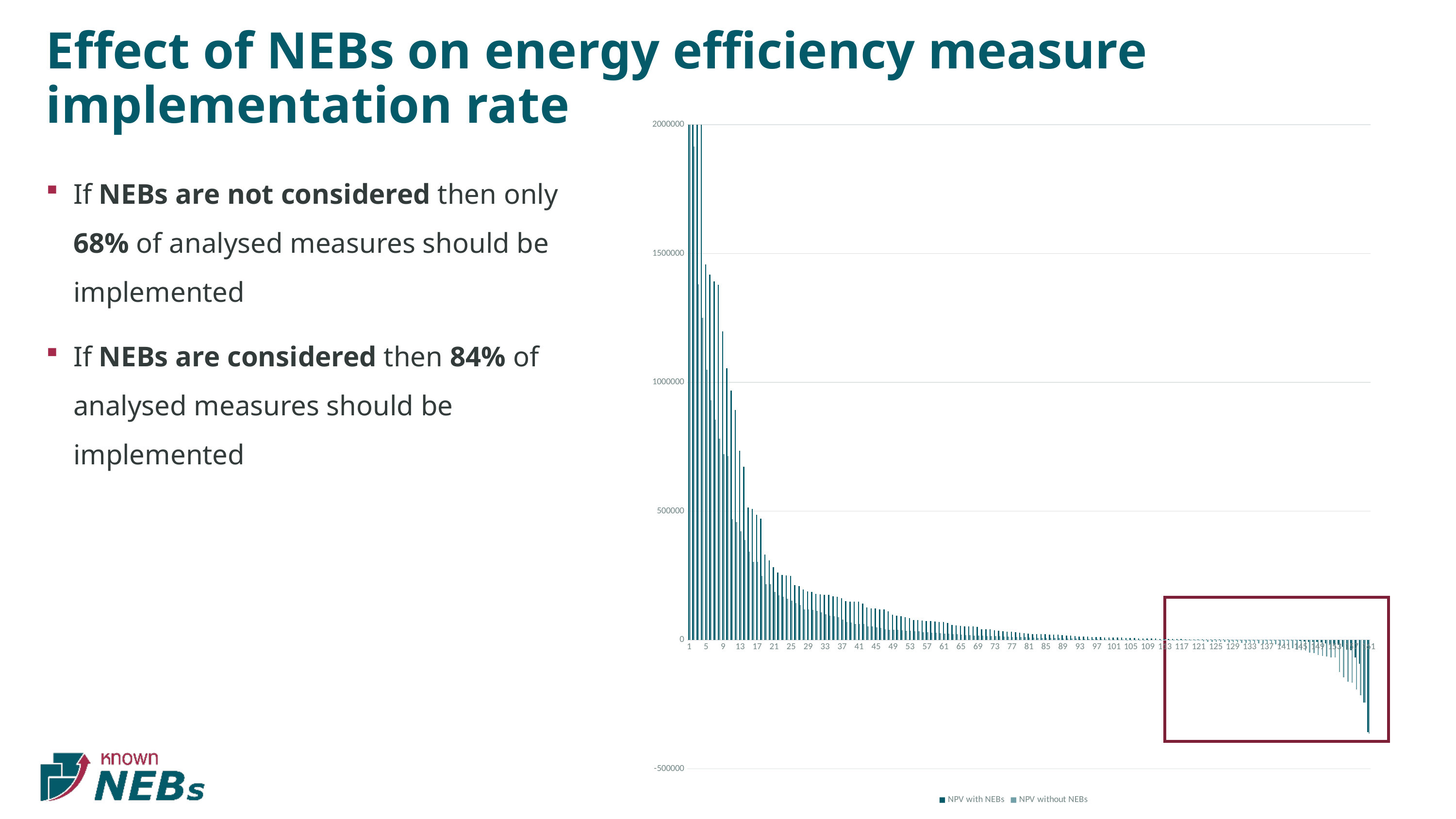
What are the two series named in the chart legend? NPV with NEBs and NPV without NEBs How many series does the chart legend list? 2 Do the bar values rise or fall as you move from left to right along the x axis? fall Is the value for category 1 greater or less than 1000000? greater What kind of chart is shown on the slide? bar chart Is the value for category 81 greater or less than 500000? less What is the lowest value shown on the chart's y axis? -500000 Is the value for category 41 greater or less than 500000? less Which category has the highest values, category 1 or category 61? category 1